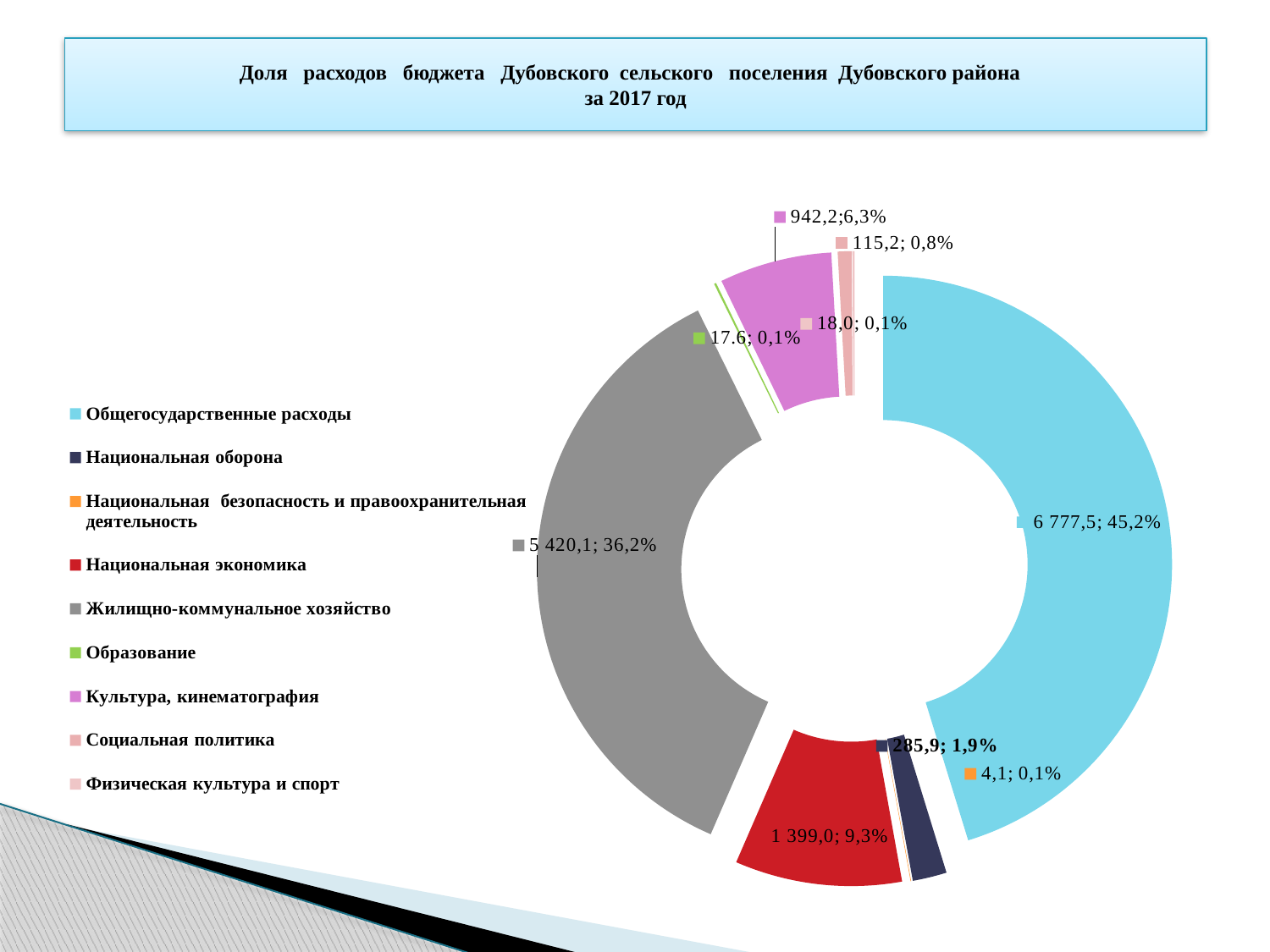
What share of the pie does Культура, кинематография have? 6,3% What is the value shown for Общегосударственные расходы? 6 777,5 What is the title of the chart on the slide? Доля расходов бюджета Дубовского сельского поселения Дубовского района за 2017 год Which category has the largest share of the pie? Общегосударственные расходы What share of the pie does Социальная политика have? 0,8% What is the value shown for Национальная экономика? 1 399,0 Which is larger, the value for Социальная политика or the value for Национальная оборона? Национальная оборона How many categories does the legend list? 9 What share of the pie does Жилищно-коммунальное хозяйство have? 36,2% What kind of chart is shown on the slide? doughnut (pie) chart What is the value shown for Национальная оборона? 285,9 What is the difference between the values for Общегосударственные расходы and Жилищно-коммунальное хозяйство? 1 357,4